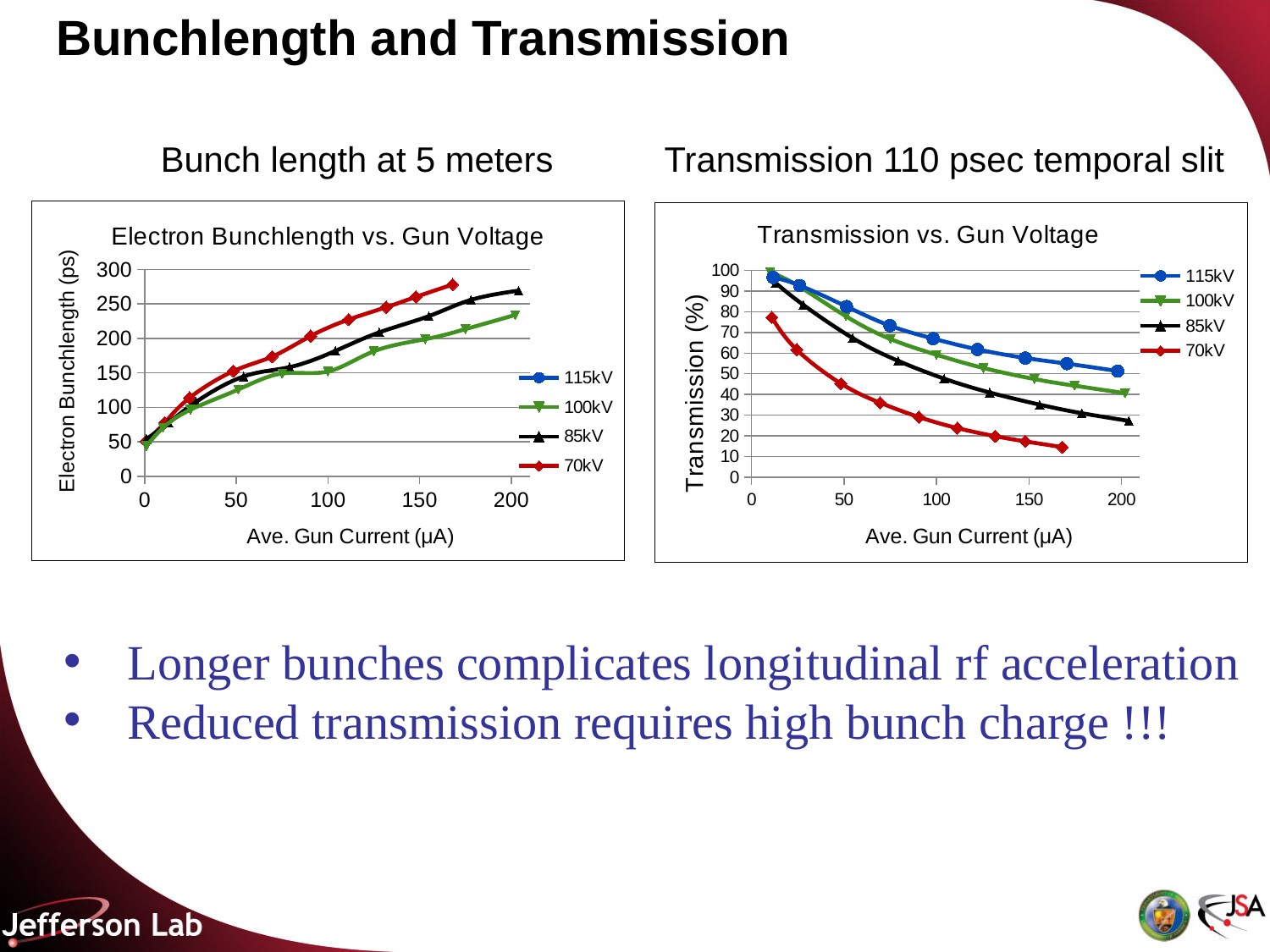
In the 'Transmission vs. Gun Voltage' chart on the right, do the transmission values rise or fall as the gun current increases? fall In the 'Electron Bunchlength vs. Gun Voltage' chart on the left, is the 70kV value at 150 µA greater or less than 250? greater In the 'Electron Bunchlength vs. Gun Voltage' chart on the left, at 100 µA, which series has the larger bunchlength, 70kV or 100kV? 70kV What kind of chart is the 'Electron Bunchlength vs. Gun Voltage' chart on the left? line chart In the 'Transmission vs. Gun Voltage' chart on the right, at 100 µA, which series has the higher transmission, 115kV or 70kV? 115kV What is the x-axis label of the 'Transmission vs. Gun Voltage' chart on the right? Ave. Gun Current (µA) In the 'Electron Bunchlength vs. Gun Voltage' chart on the left, is the 100kV value at 200 µA greater or less than 250? less In the 'Transmission vs. Gun Voltage' chart on the right, is the 85kV value at 200 µA greater or less than 30? less How many series does the legend of the 'Transmission vs. Gun Voltage' chart on the right list? 4 What are the legend entries of the 'Electron Bunchlength vs. Gun Voltage' chart on the left? 115kV, 100kV, 85kV, 70kV In the 'Electron Bunchlength vs. Gun Voltage' chart on the left, do the bunchlength values rise or fall as the gun current increases? rise